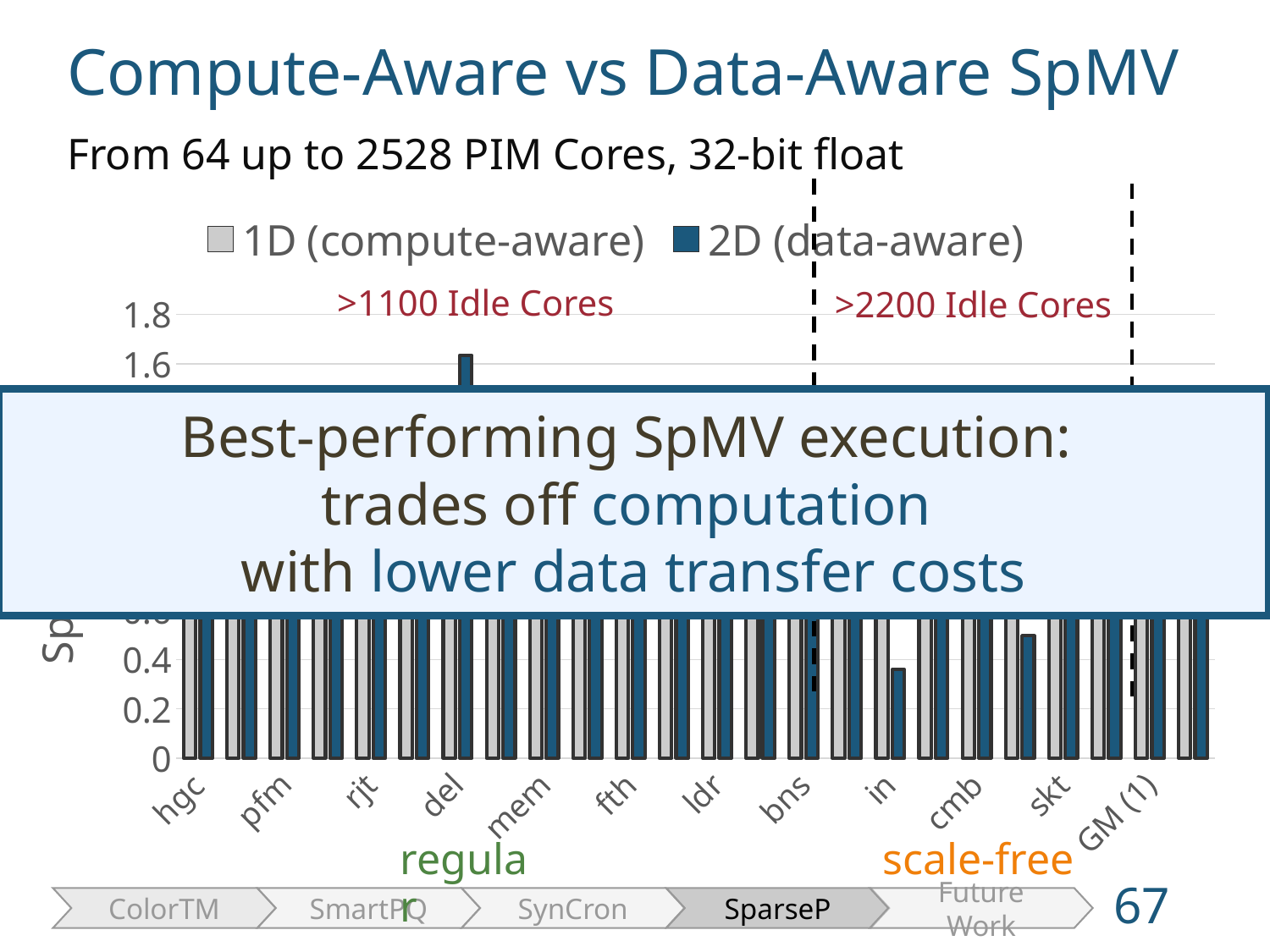
What annotation is written above the chart on the left side, near the del bars? >1100 Idle Cores Is the 2D (data-aware) value for del greater or less than 1.4? greater For the matrix del, which series has the larger value, 1D (compute-aware) or 2D (data-aware)? 2D (data-aware) What are the two series named in the chart legend? 1D (compute-aware) and 2D (data-aware) For the matrix in, which series has the larger value, 1D (compute-aware) or 2D (data-aware)? 1D (compute-aware) What kind of chart is shown on the slide? bar chart Is the 2D (data-aware) value for in greater or less than 0.6? less How many series does the chart legend list? 2